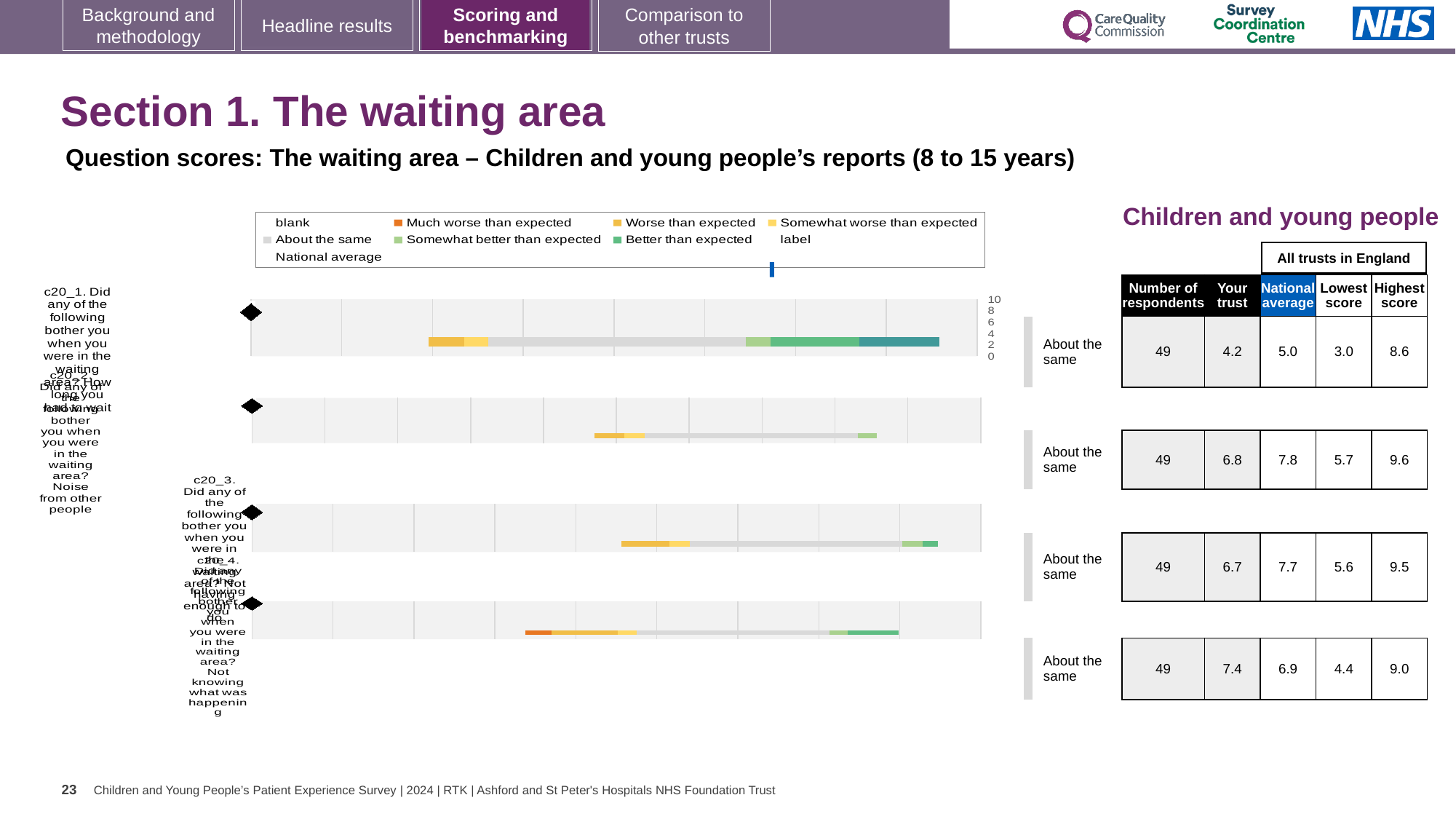
In the second row of the table, what is the difference between the 'National average' (7.8) and the 'Your trust' score (6.8)? 1.0 In the table beside the chart, how many respondents are listed for each question? 49 In the table beside the chart, what is the 'Your trust' score in the first row? 4.2 In the table beside the chart, what is the 'Highest score' in the second row? 9.6 In the chart legend, what colour represents 'Better than expected'? green What kind of chart is shown on the slide? bar chart In the fourth row of the table, which is larger: the 'Your trust' score or the 'National average'? Your trust In the chart legend, what colour represents 'Much worse than expected'? orange Which row of the table has the highest 'Your trust' score? the fourth row (7.4) In the table beside the chart, what is the 'Lowest score' in the third row? 5.6 How many question bars are plotted in the chart? 4 In the table beside the chart, what is the 'National average' in the first row? 5.0